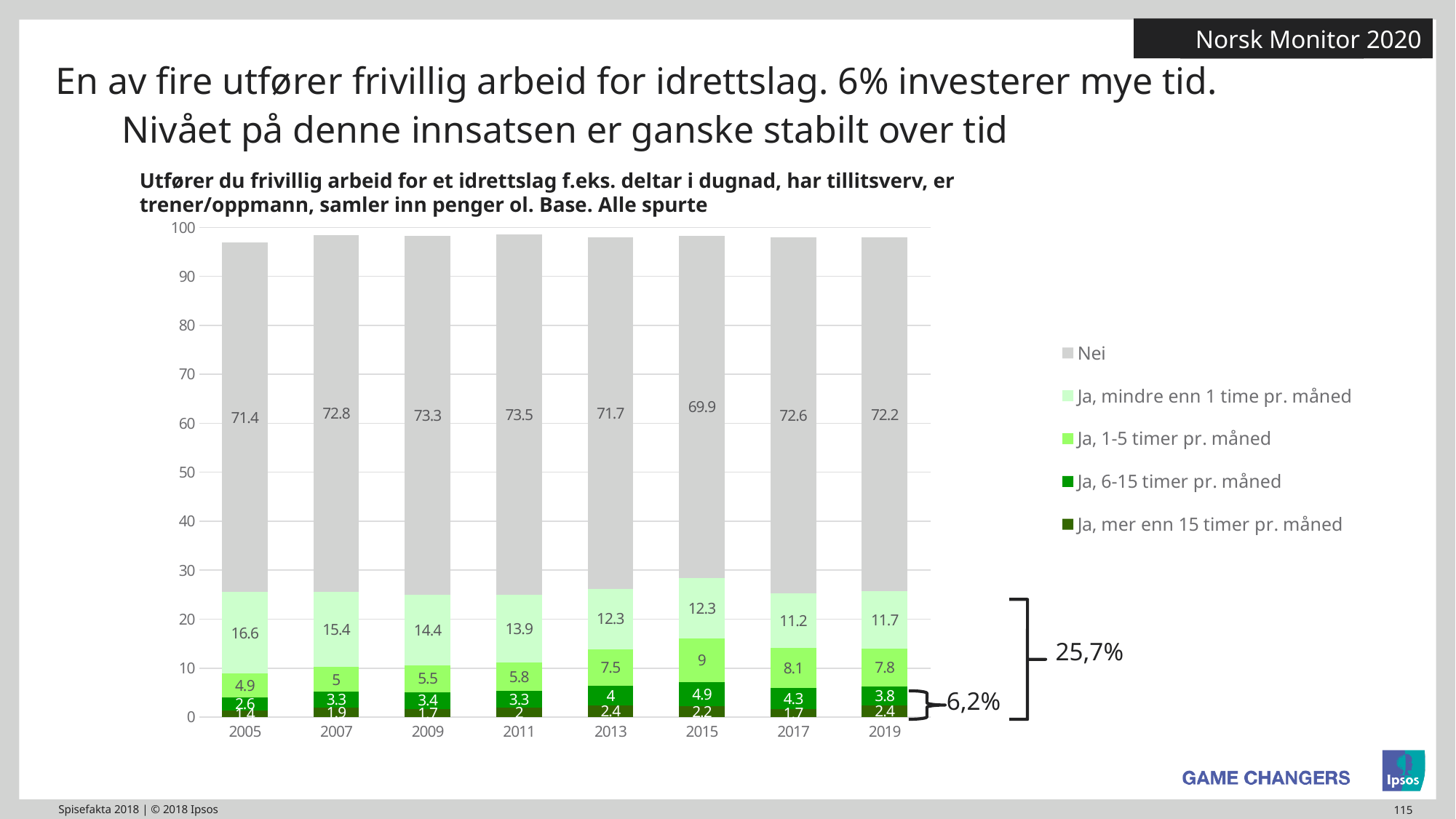
How many years are shown on the x axis? 8 What is the difference between the "Ja, mindre enn 1 time pr. måned" values in 2005 and 2019? 4.9 What percentage is shown by the large bracket annotation to the right of the 2019 bar? 25,7% How many series does the legend list? 5 In which year is the "Nei" value lowest? 2015 Which year has the larger value for "Ja, 1-5 timer pr. måned": 2013 or 2015? 2015 What is the value for "Nei" in 2015? 69.9 What kind of chart is shown on the slide? Stacked bar chart In which year is the "Nei" value highest? 2011 Does the value for "Ja, mindre enn 1 time pr. måned" rise or fall from 2005 to 2011? Fall What is the total of the stacked bar for 2019? 97.9 What is the value for "Ja, 1-5 timer pr. måned" in 2019? 7.8